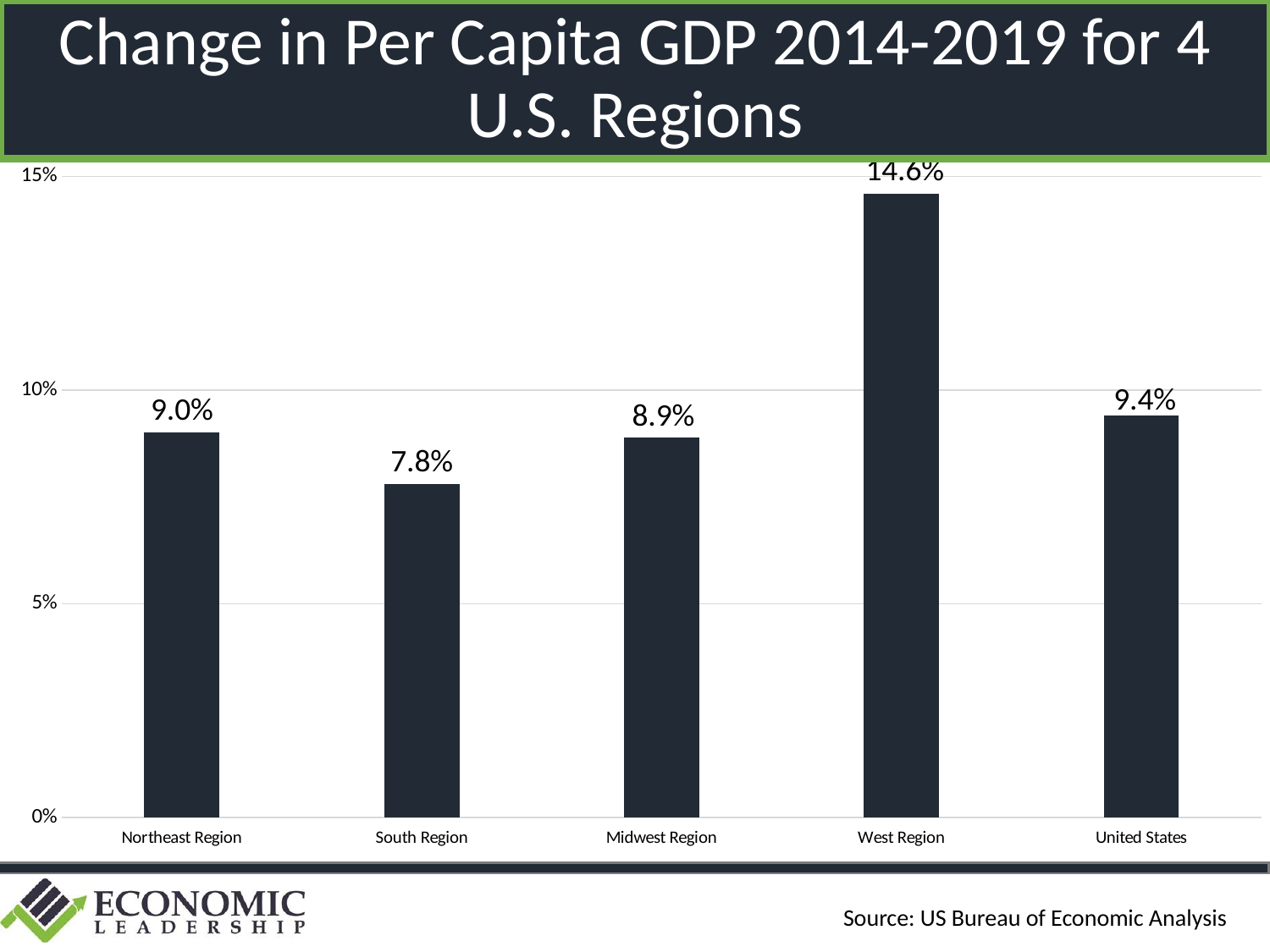
Is the value for the West Region greater or less than 10%? greater Which category has the highest change in per capita GDP? West Region What kind of chart is shown on the slide? Bar chart What is the difference between the United States value and the Northeast Region value? 0.4% What is the change in per capita GDP for the South Region? 7.8% Which category has the lowest change in per capita GDP? South Region Which is larger, the value for the Northeast Region or the South Region? Northeast Region How many categories are shown on the x axis? 5 What is the value shown for the Midwest Region? 8.9% What is the value shown for the United States? 9.4% What is the difference between the West Region and the South Region values? 6.8% What is the change in per capita GDP for the West Region? 14.6%